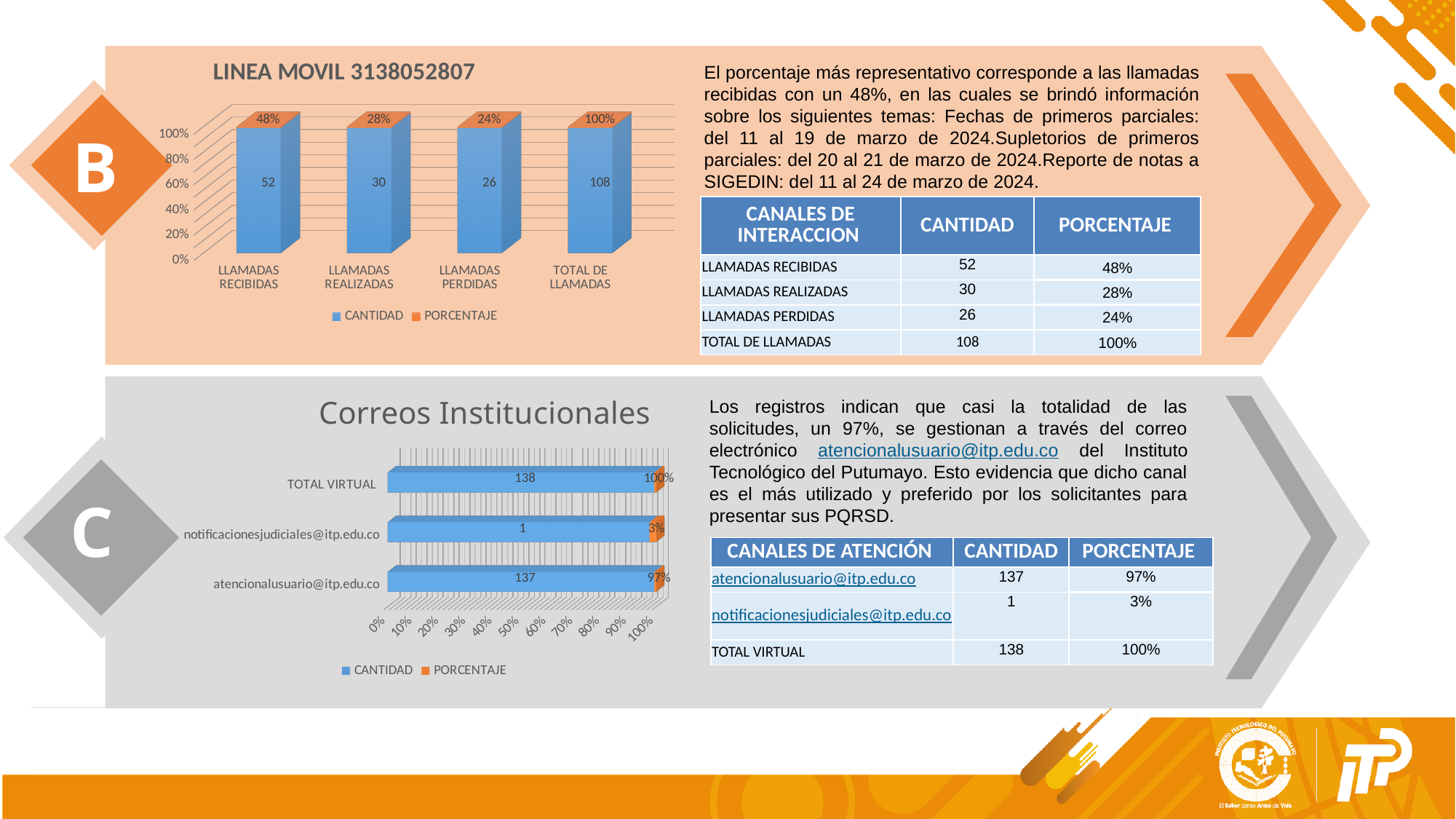
In the 'Correos Institucionales' chart, what is the CANTIDAD value for atencionalusuario@itp.edu.co? 137 In the 'Correos Institucionales' chart, which category has the highest CANTIDAD value? TOTAL VIRTUAL In the 'LINEA MOVIL 3138052807' chart, how many categories are shown on the x axis? 4 What kind of chart is the 'Correos Institucionales' chart? Bar chart In the 'Correos Institucionales' chart, what PORCENTAJE is shown for notificacionesjudiciales@itp.edu.co? 3% In the 'LINEA MOVIL 3138052807' chart, what is the difference between the CANTIDAD values for LLAMADAS RECIBIDAS and LLAMADAS REALIZADAS? 22 In the 'LINEA MOVIL 3138052807' chart, which category has the lowest CANTIDAD value? LLAMADAS PERDIDAS What is the title of the chart in the top section of the slide? LINEA MOVIL 3138052807 In the 'LINEA MOVIL 3138052807' chart, what PORCENTAJE is shown for LLAMADAS PERDIDAS? 24% In the 'LINEA MOVIL 3138052807' chart, what is the CANTIDAD value for LLAMADAS RECIBIDAS? 52 In the 'Correos Institucionales' chart, which has a larger PORCENTAJE: atencionalusuario@itp.edu.co or notificacionesjudiciales@itp.edu.co? atencionalusuario@itp.edu.co In the 'LINEA MOVIL 3138052807' chart, how many series does the legend list? 2